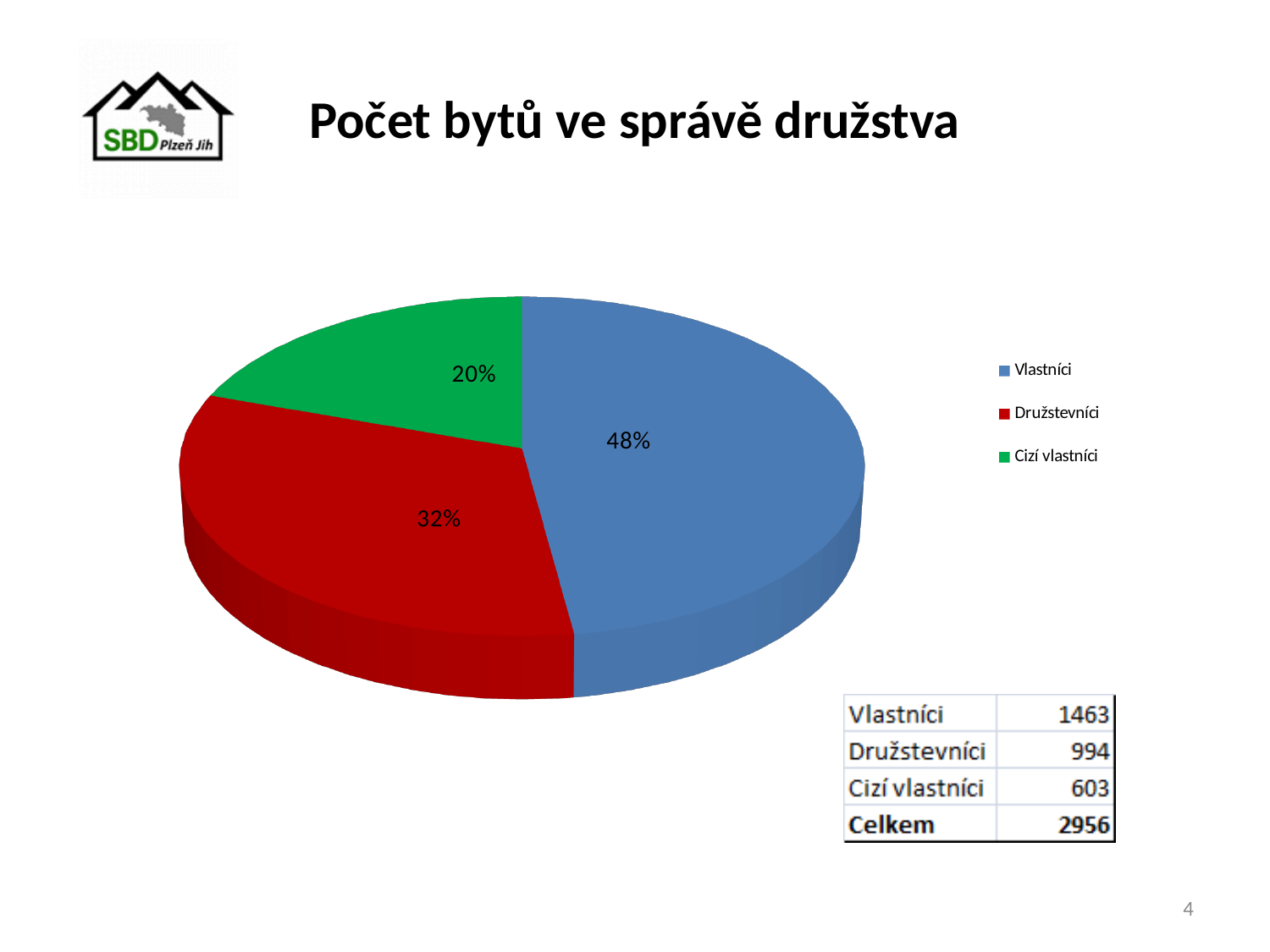
Which is larger, the share for Družstevníci or the share for Cizí vlastníci? Družstevníci What share of the pie does Vlastníci represent? 48% What share of the pie does Cizí vlastníci represent? 20% Which category has the largest slice of the pie? Vlastníci How many entries does the legend list? 3 Which category has the smallest slice of the pie? Cizí vlastníci What colour is the slice for Cizí vlastníci? green What is the difference in percentage points between the Vlastníci share and the Družstevníci share? 16 What is the title of the chart on the slide? Počet bytů ve správě družstva What share of the pie does Družstevníci represent? 32% How many categories does the pie chart show? 3 What kind of chart is shown on the slide? pie chart